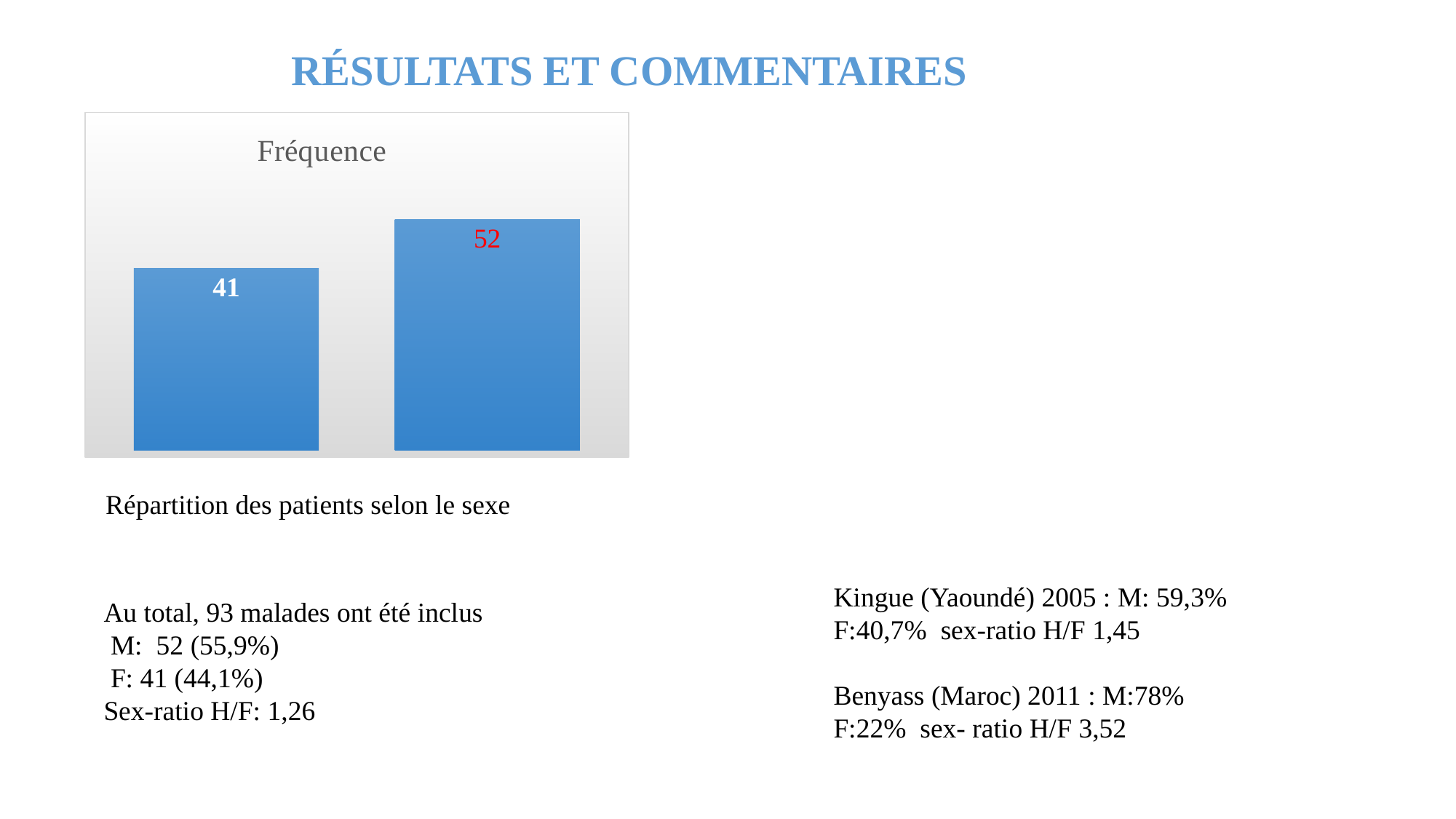
Is the value of the left bar larger or smaller than the value of the right bar? smaller How many bars are plotted in the chart? 2 What caption is written directly below the chart? Répartition des patients selon le sexe What is the difference between the values of the right bar and the left bar? 11 Do the bar values rise or fall from left to right? rise Which bar has the highest value, the left or the right one? the right bar (52) What is the title of the chart? Fréquence Which bar has the lowest value, the left or the right one? the left bar (41) What is the value shown on the right bar of the chart? 52 What kind of chart is shown on the slide? bar chart What is the value shown on the left bar of the chart? 41 What is the sum of the two bar values in the chart? 93